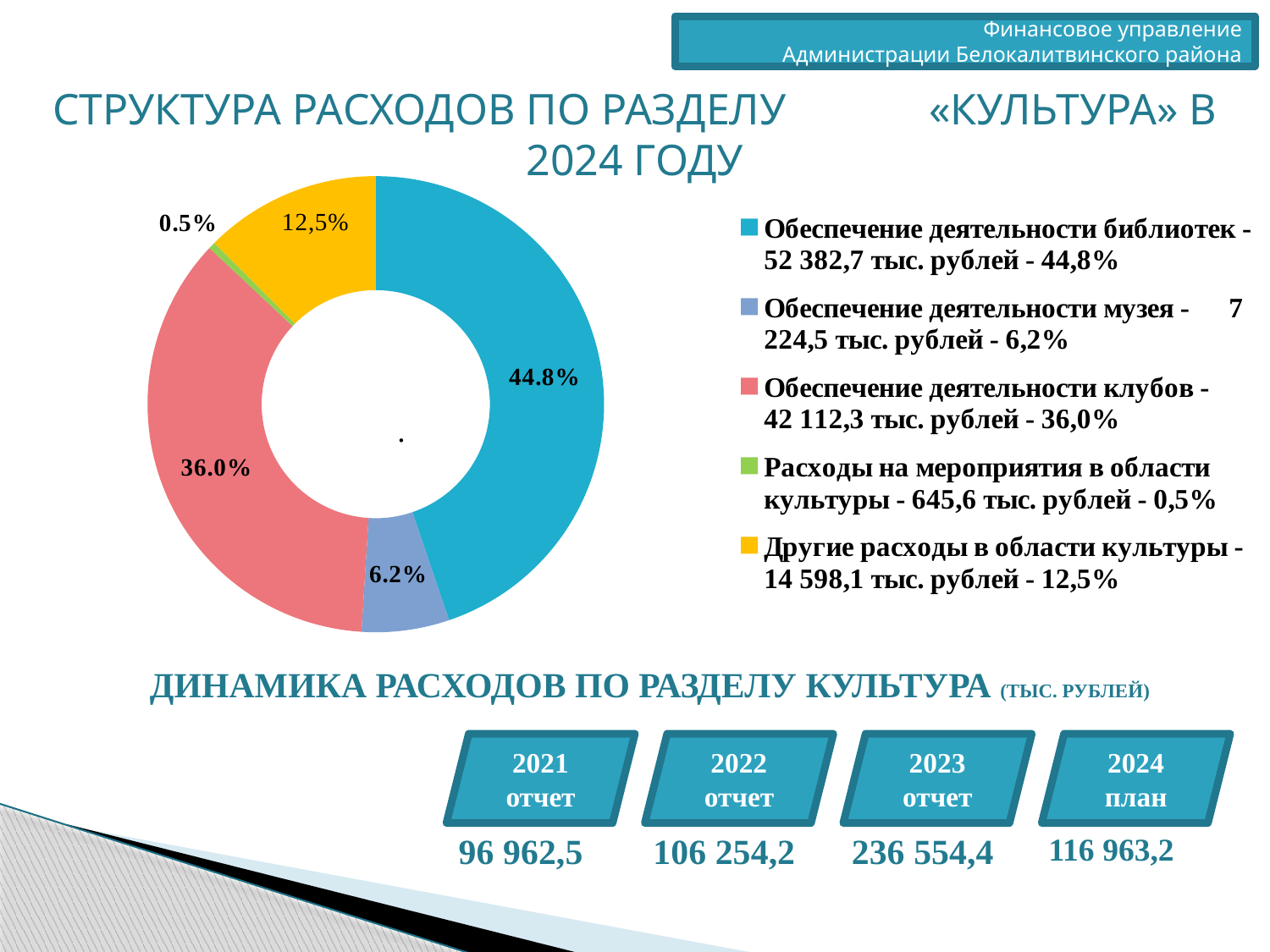
What colour is the slice for 'Обеспечение деятельности клубов'? Red (pink) What share of the chart is labelled for 'Расходы на мероприятия в области культуры'? 0.5% What kind of chart is shown on the slide? Doughnut (pie) chart Which category has the largest slice in the doughnut chart? Обеспечение деятельности библиотек What share of the chart is labelled for 'Обеспечение деятельности музея'? 6.2% What share of the chart is labelled for 'Обеспечение деятельности библиотек'? 44.8% How many slices does the doughnut chart have? 5 How many entries does the legend of the doughnut chart list? 5 Which category has the smallest slice in the doughnut chart? Расходы на мероприятия в области культуры Which slice is larger: 'Обеспечение деятельности клубов' or 'Другие расходы в области культуры'? Обеспечение деятельности клубов According to the legend, what is the amount in thousand rubles for 'Другие расходы в области культуры'? 14 598,1 тыс. рублей